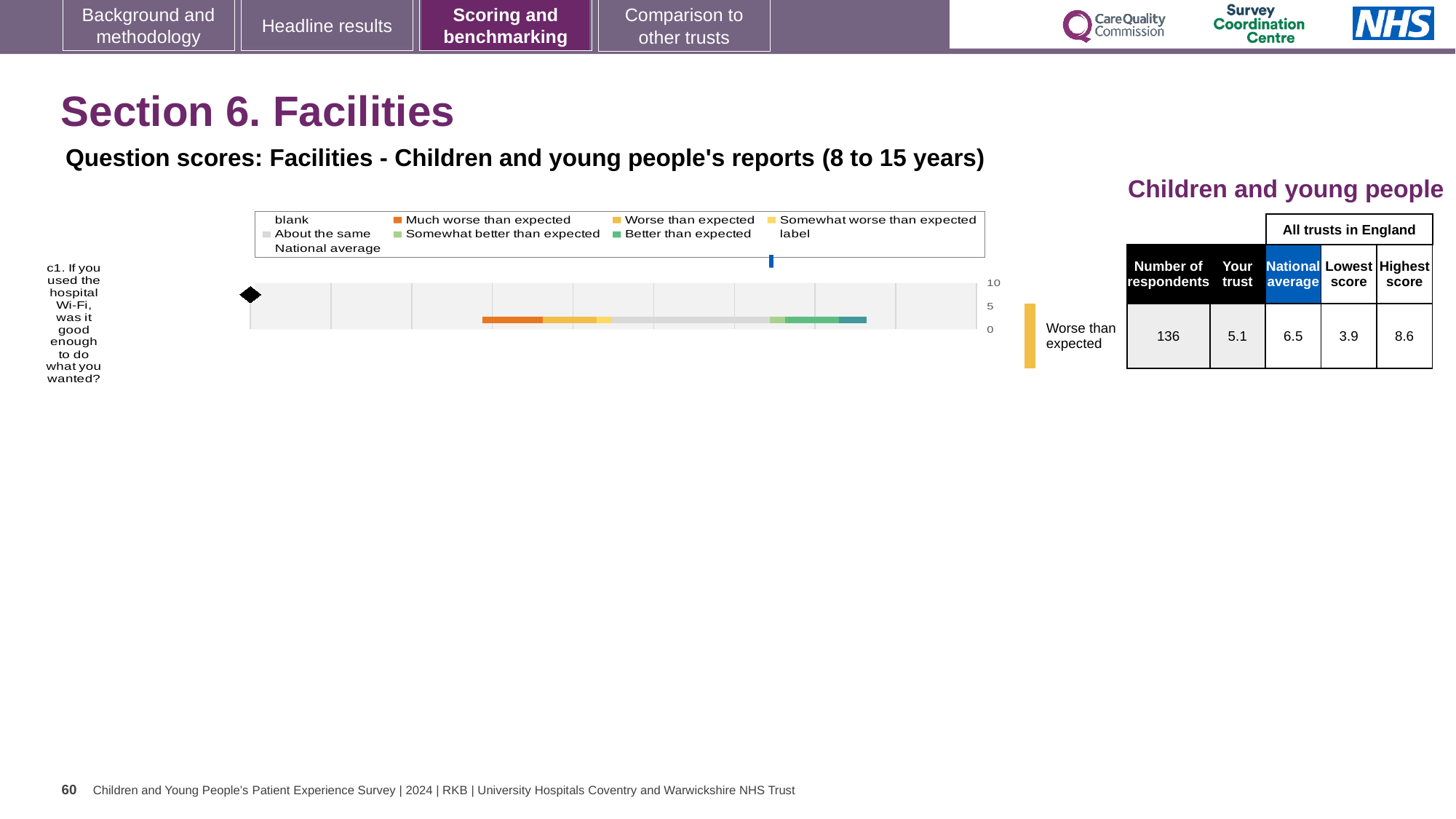
For question c1, which is larger: the trust's score or the national average? National average How many respondents answered question c1 about hospital Wi-Fi? 136 What is the difference between the highest score and the lowest score for question c1? 4.7 What is the highest score among all trusts in England for question c1, as shown in the table? 8.6 What is the lowest score among all trusts in England for question c1, as shown in the table? 3.9 Which colour in the chart legend represents 'Much worse than expected'? Orange Which benchmark category is the trust's result for question c1 assigned to? Worse than expected What kind of chart is used to show the question score for c1 on this slide? bar chart How many survey questions are plotted in the chart on this slide? 1 How much lower is the trust's score than the national average for question c1? 1.4 According to the table beside the chart, what is the 'Your trust' score for question c1 about hospital Wi-Fi? 5.1 According to the table beside the chart, what is the national average score for question c1? 6.5